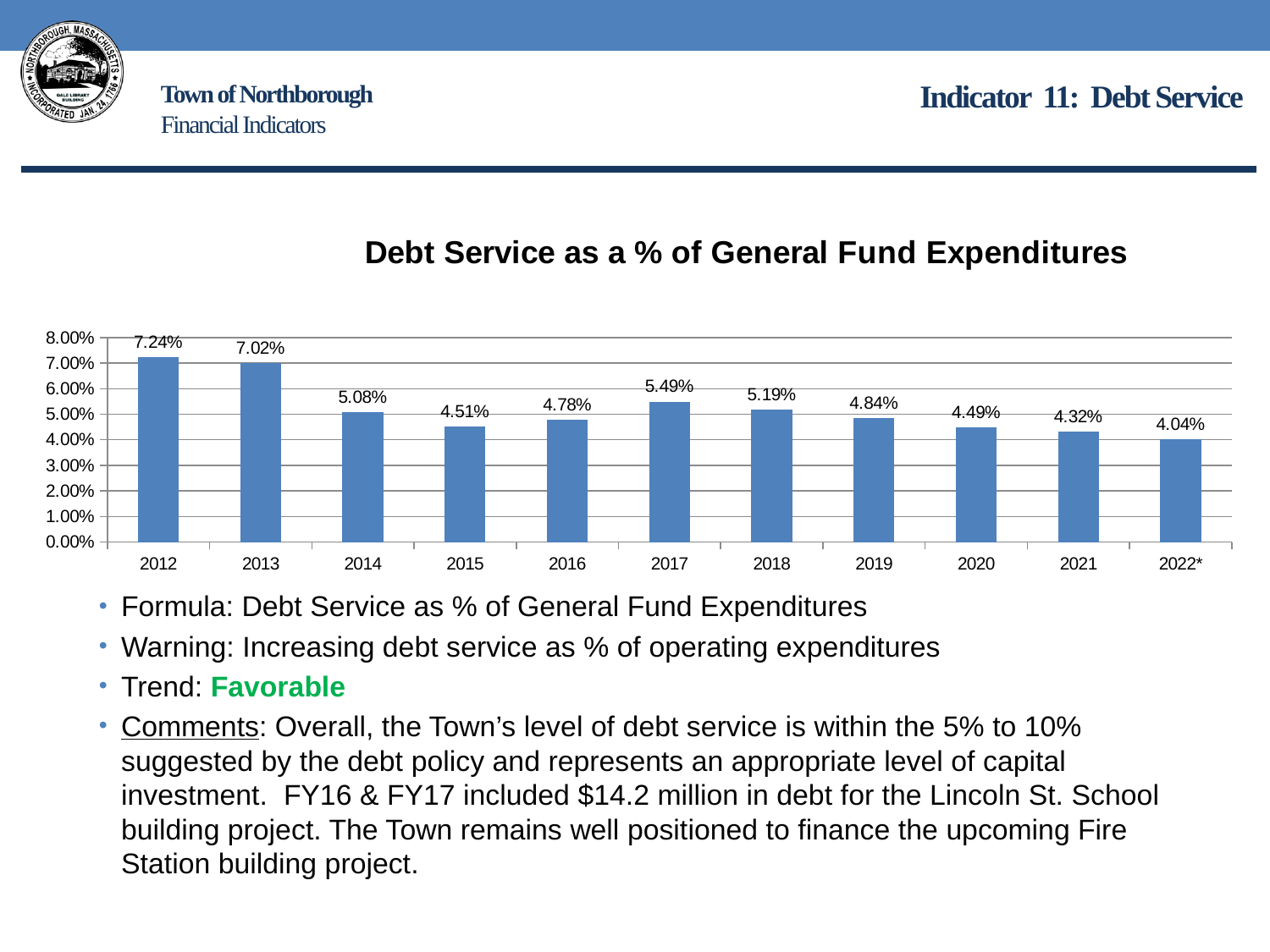
What is the difference between the values for 2012 and 2013? 0.22% How many years are shown on the x axis of the chart? 11 Which year has a larger value, 2014 or 2015? 2014 What is the title of the chart? Debt Service as a % of General Fund Expenditures What is the value shown for 2017? 5.49% Which year has the highest debt service as a % of general fund expenditures? 2012 What kind of chart is shown on the slide? bar chart What is the difference between the values for 2017 and 2018? 0.30% What is the debt service as a % of general fund expenditures for 2012? 7.24% Which year has the lowest debt service as a % of general fund expenditures? 2022* Is the value for 2016 greater or less than 5.00%? less What is the value shown for 2022*? 4.04%